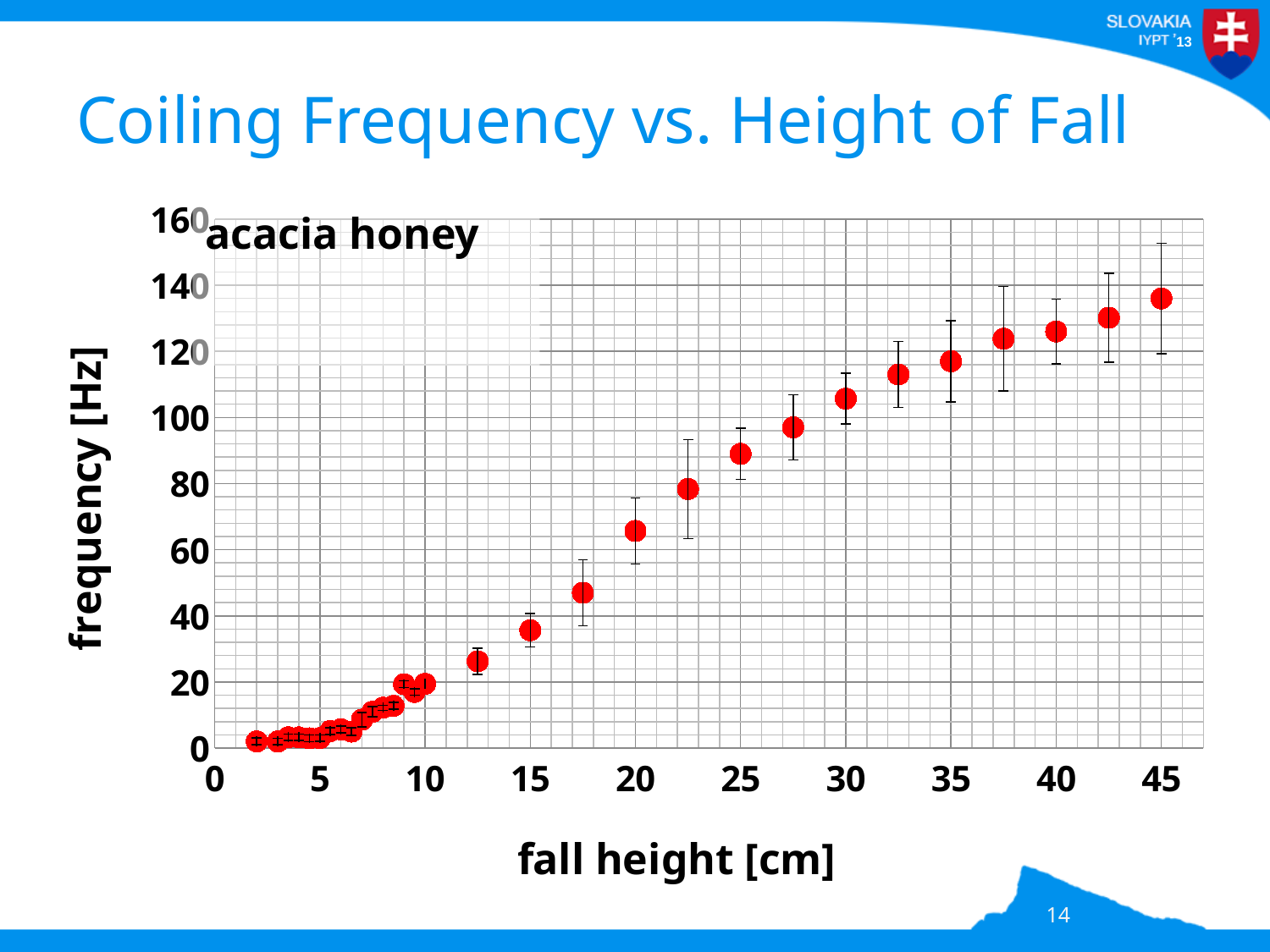
Does the coiling frequency rise or fall as the fall height increases? rise Is the frequency at a fall height of 5 cm greater or less than 20 Hz? less What kind of chart is shown on the slide? scatter plot Is the frequency at a fall height of 45 cm greater or less than 120 Hz? greater Which fall height gives a lower frequency, 10 cm or 30 cm? 10 cm At which fall height is the coiling frequency highest? 45 cm Is the frequency at a fall height of 25 cm greater or less than 80 Hz? greater What is the label of the y axis? frequency [Hz] Which fall height gives a higher frequency, 20 cm or 40 cm? 40 cm What is the label of the x axis? fall height [cm]